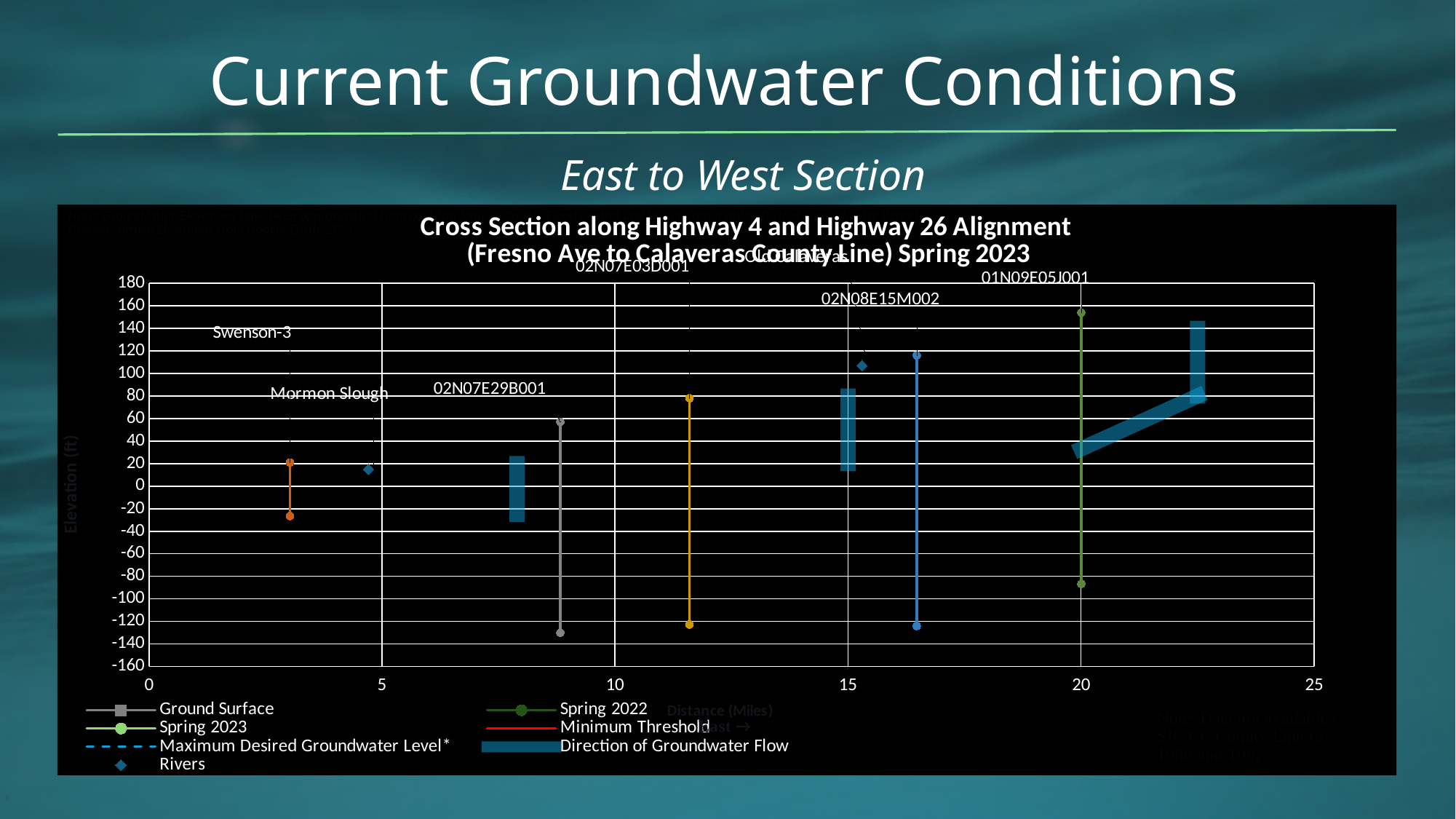
Is the top of the vertical line at 02N07E03D001 greater or less than 60? greater How many river (diamond) markers are plotted on the chart? 2 What is the title of the chart? Cross Section along Highway 4 and Highway 26 Alignment (Fresno Ave to Calaveras County Line) Spring 2023 Is the bottom of the vertical line at 02N08E15M002 greater or less than -100? less How many entries does the chart legend list? 7 Is the bottom of the vertical line at 02N07E29B001 greater or less than -120? less Which well has the highest top point on the chart, 01N09E05J001 or 02N07E29B001? 01N09E05J001 What is the highest value shown on the vertical (Elevation) axis? 180